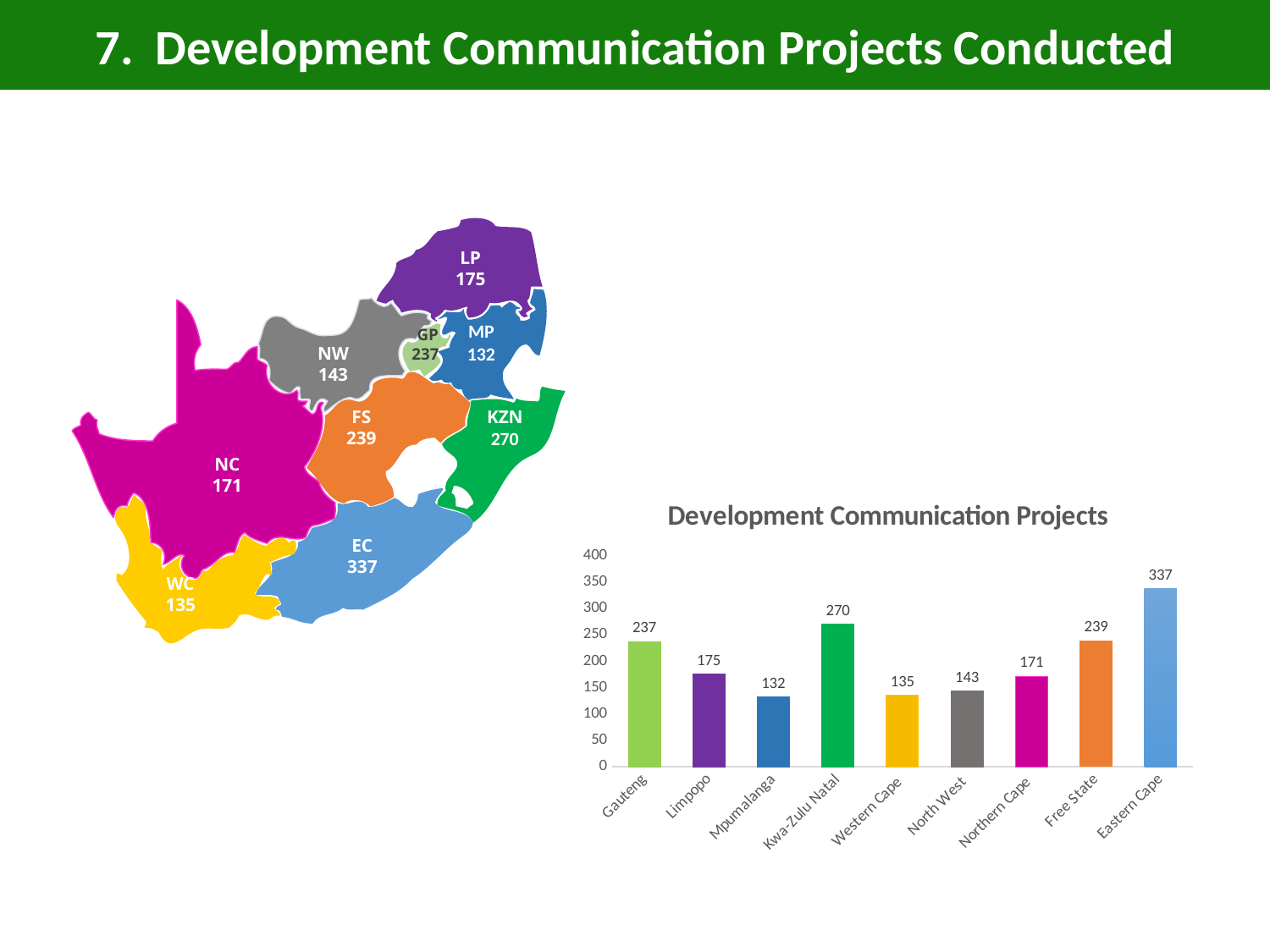
Which province has the lowest value in the Development Communication Projects chart? Mpumalanga What kind of chart is the Development Communication Projects chart? bar chart What is the title of the chart on the slide? Development Communication Projects What is the value for Kwa-Zulu Natal in the Development Communication Projects chart? 270 How many provinces are shown in the Development Communication Projects chart? 9 What is the value for Free State in the Development Communication Projects chart? 239 What is the difference between the values for Western Cape and Mpumalanga in the Development Communication Projects chart? 3 Is the value for North West in the Development Communication Projects chart greater or less than 200? less What is the value for Gauteng in the Development Communication Projects chart? 237 Which is larger in the Development Communication Projects chart, the value for Limpopo or the value for Northern Cape? Limpopo Which province has the highest value in the Development Communication Projects chart? Eastern Cape What is the difference between the values for Eastern Cape and Mpumalanga in the Development Communication Projects chart? 205